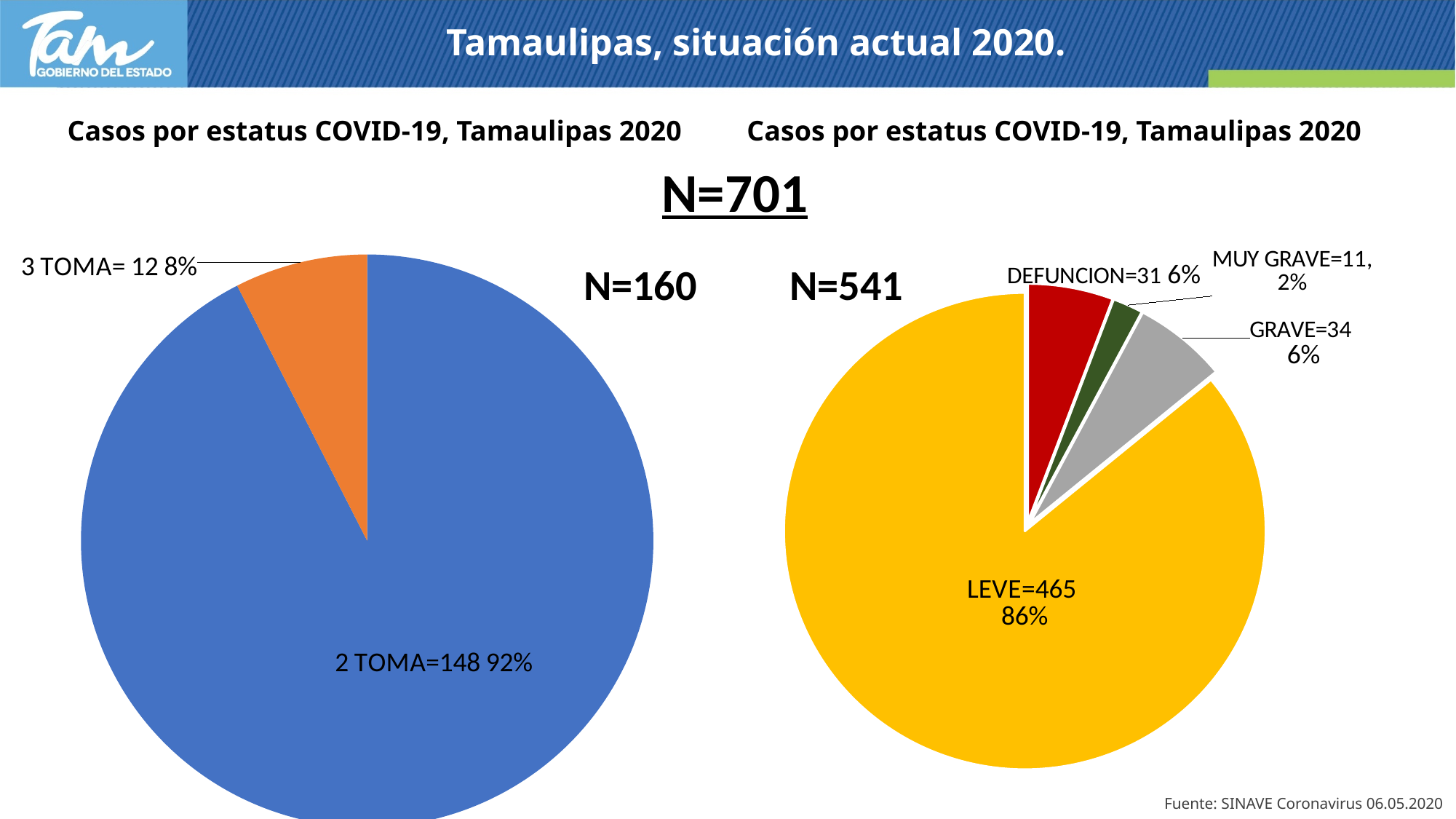
In the right pie chart, how many cases are labelled LEVE? 465 In the left pie chart, what is the difference in cases between 2 TOMA and 3 TOMA? 136 In the right pie chart, how many slices are there? 4 What type of chart is the left chart on the slide? pie chart In the right pie chart, what is the difference in cases between GRAVE and DEFUNCION? 3 In the right pie chart, what percentage share does LEVE have? 86% In the right pie chart, how many cases are labelled GRAVE? 34 In the left pie chart, how many cases are labelled 2 TOMA? 148 In the left pie chart, what percentage share does 3 TOMA have? 8% In the right pie chart, which category has the largest slice? LEVE In the left pie chart, how many slices are there? 2 In the right pie chart, which category has the smallest slice? MUY GRAVE